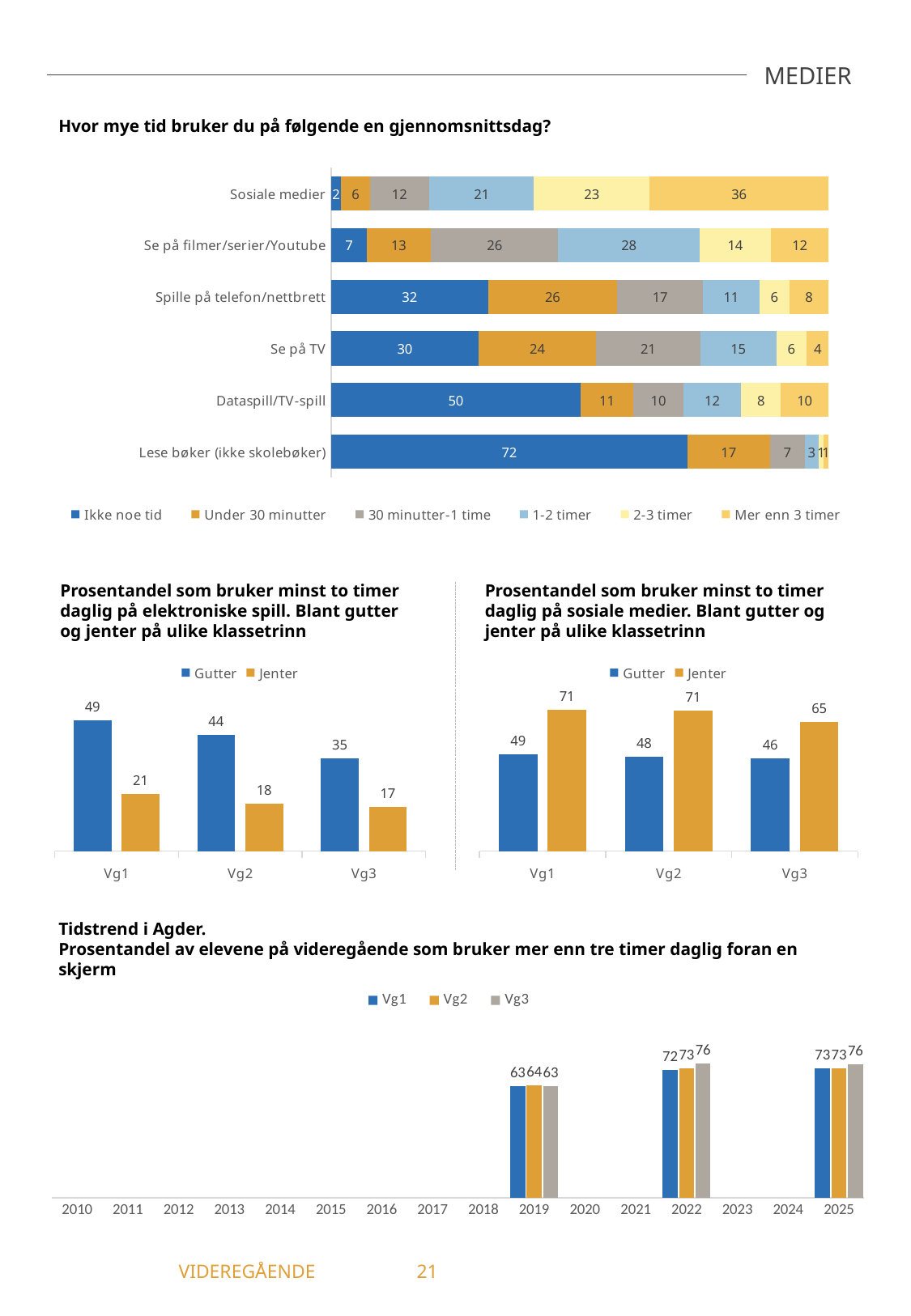
In the chart 'Hvor mye tid bruker du på følgende en gjennomsnittsdag?', how many series does the legend list? 6 In the chart 'Hvor mye tid bruker du på følgende en gjennomsnittsdag?', which category has the highest value for 'Ikke noe tid'? Lese bøker (ikke skolebøker) In the chart about minst to timer daglig på elektroniske spill, do the Gutter values rise or fall from Vg1 to Vg3? fall In the chart about minst to timer daglig på elektroniske spill, what is the value for Gutter at Vg1? 49 In the chart about minst to timer daglig på sosiale medier, what is the value for Jenter at Vg3? 65 In the chart 'Hvor mye tid bruker du på følgende en gjennomsnittsdag?', what is the value for 'Mer enn 3 timer' for Sosiale medier? 36 In the chart about minst to timer daglig på sosiale medier, which is larger at Vg2, Gutter or Jenter? Jenter In the chart 'Tidstrend i Agder', what is the value for Vg3 in 2025? 76 What kind of chart is the 'Tidstrend i Agder' chart? bar chart In the chart about minst to timer daglig på elektroniske spill, what is the difference between Gutter and Jenter at Vg3? 18 In the chart 'Hvor mye tid bruker du på følgende en gjennomsnittsdag?', what is the value for 'Ikke noe tid' for Lese bøker (ikke skolebøker)? 72 In the chart 'Hvor mye tid bruker du på følgende en gjennomsnittsdag?', how many activity categories are shown? 6